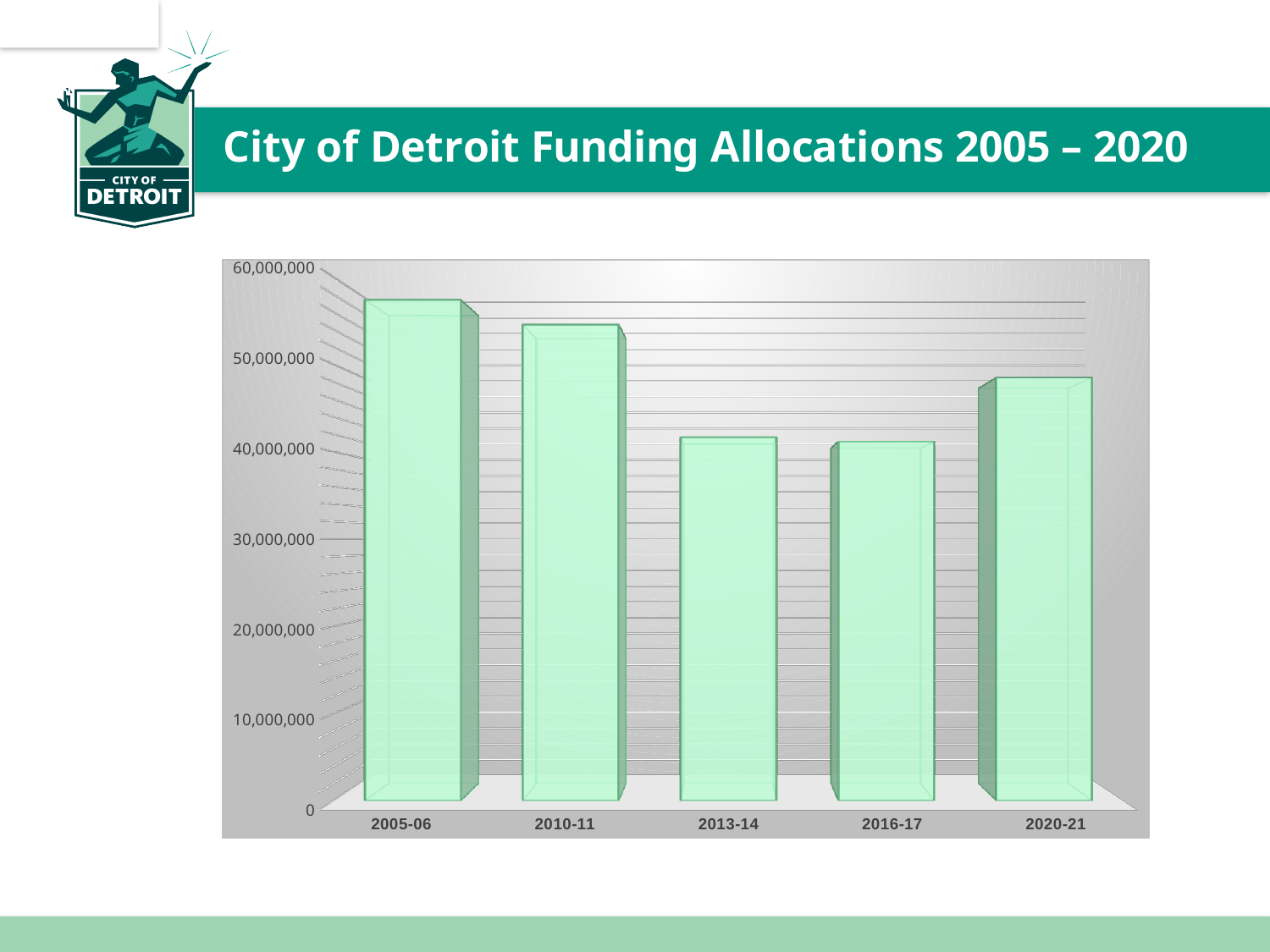
Do the values rise or fall from 2016-17 to 2020-21? rise Is the value for 2005-06 greater or less than 50,000,000? greater Which is larger, the allocation for 2010-11 or for 2016-17? 2010-11 Which fiscal year has the highest funding allocation? 2005-06 Is the value for 2020-21 greater or less than 40,000,000? greater What is the title of the slide containing the chart? City of Detroit Funding Allocations 2005 – 2020 Is the value for 2016-17 greater or less than 50,000,000? less What kind of chart is shown on the slide? bar chart Which is larger, the allocation for 2005-06 or for 2020-21? 2005-06 How many fiscal-year categories are plotted on the x axis? 5 Do the values rise or fall from 2005-06 to 2016-17? fall